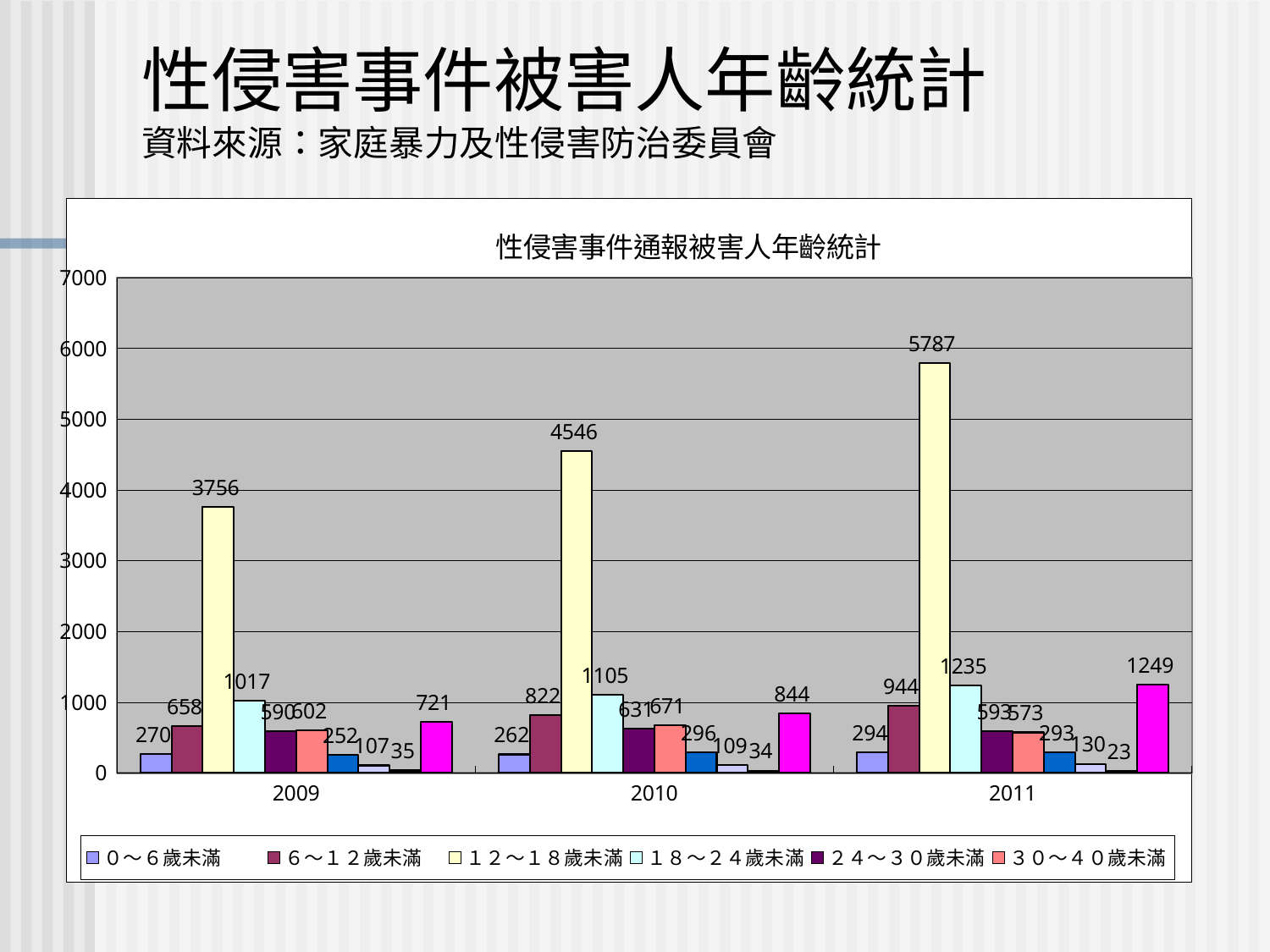
In 2011, which is larger: 24～30歲未滿 or 30～40歲未滿? 24～30歲未滿 What is the value for 12～18歲未滿 in 2011? 5787 Do the values for 12～18歲未滿 rise or fall from 2009 to 2011? rise How many series does the legend list? 6 What is the value for 30～40歲未滿 in 2011? 573 What kind of chart is shown on the slide? bar chart In which year is the value for 0～6歲未滿 the lowest? 2010 What is the value for 6～12歲未滿 in 2010? 822 What is the difference between the 12～18歲未滿 values for 2011 and 2010? 1241 What is the value for 18～24歲未滿 in 2009? 1017 In which year is the value for 12～18歲未滿 the highest? 2011 How many years are shown on the x axis? 3